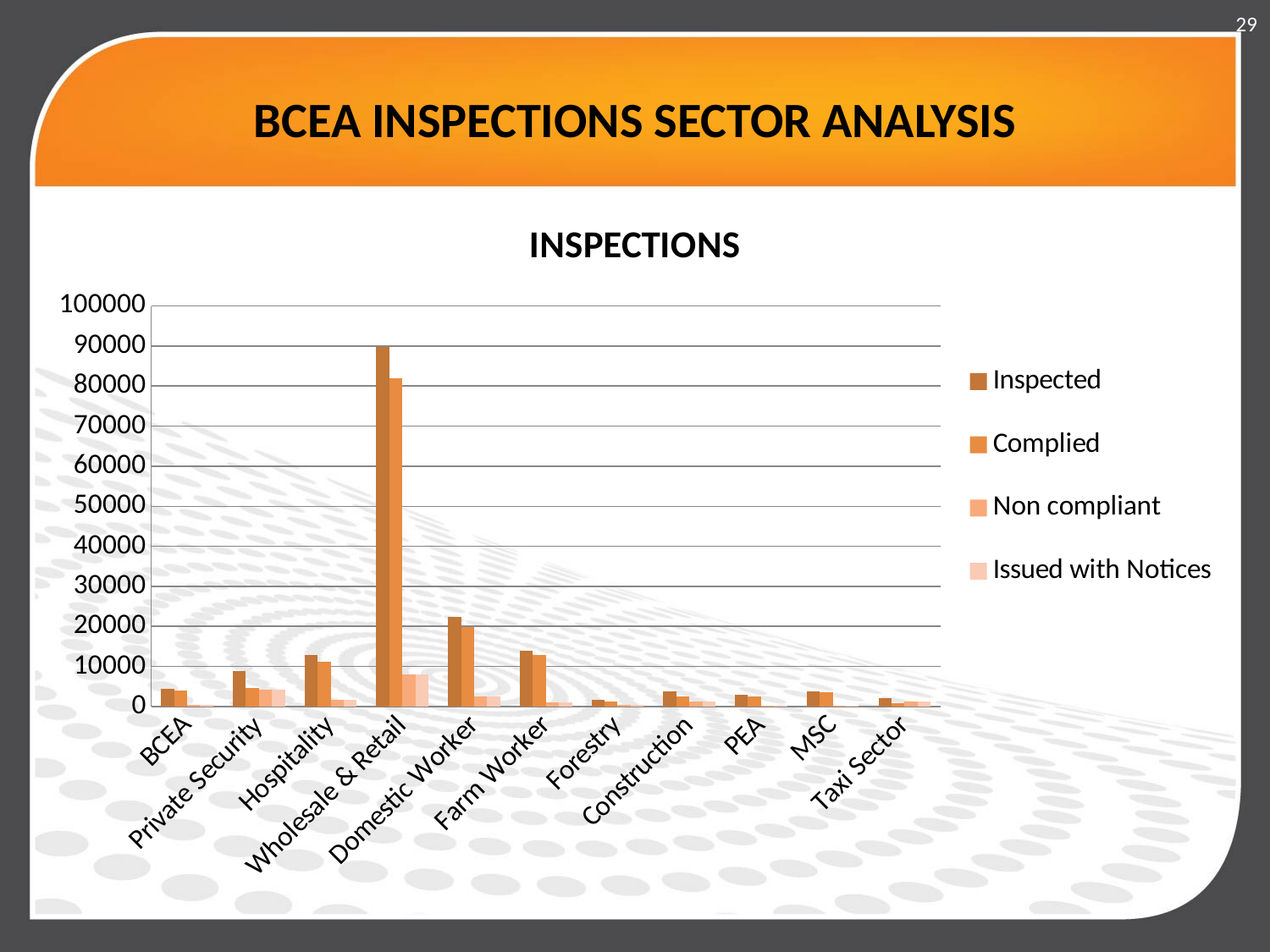
Which sector has a higher Inspected value, Domestic Worker or Farm Worker? Domestic Worker How many sectors (categories) are shown on the x axis of the INSPECTIONS chart? 11 Is the Inspected value for Hospitality greater or less than 20000? less Which sector has the highest Inspected value? Wholesale & Retail Which series is listed last in the legend? Issued with Notices What kind of chart is shown on the slide? bar chart Is the Complied value for Wholesale & Retail greater or less than 90000? less What is the title of the chart? INSPECTIONS How many series does the legend of the INSPECTIONS chart list? 4 Is the Inspected value for Domestic Worker greater or less than 20000? greater Which sector has a higher Inspected value, Private Security or Forestry? Private Security